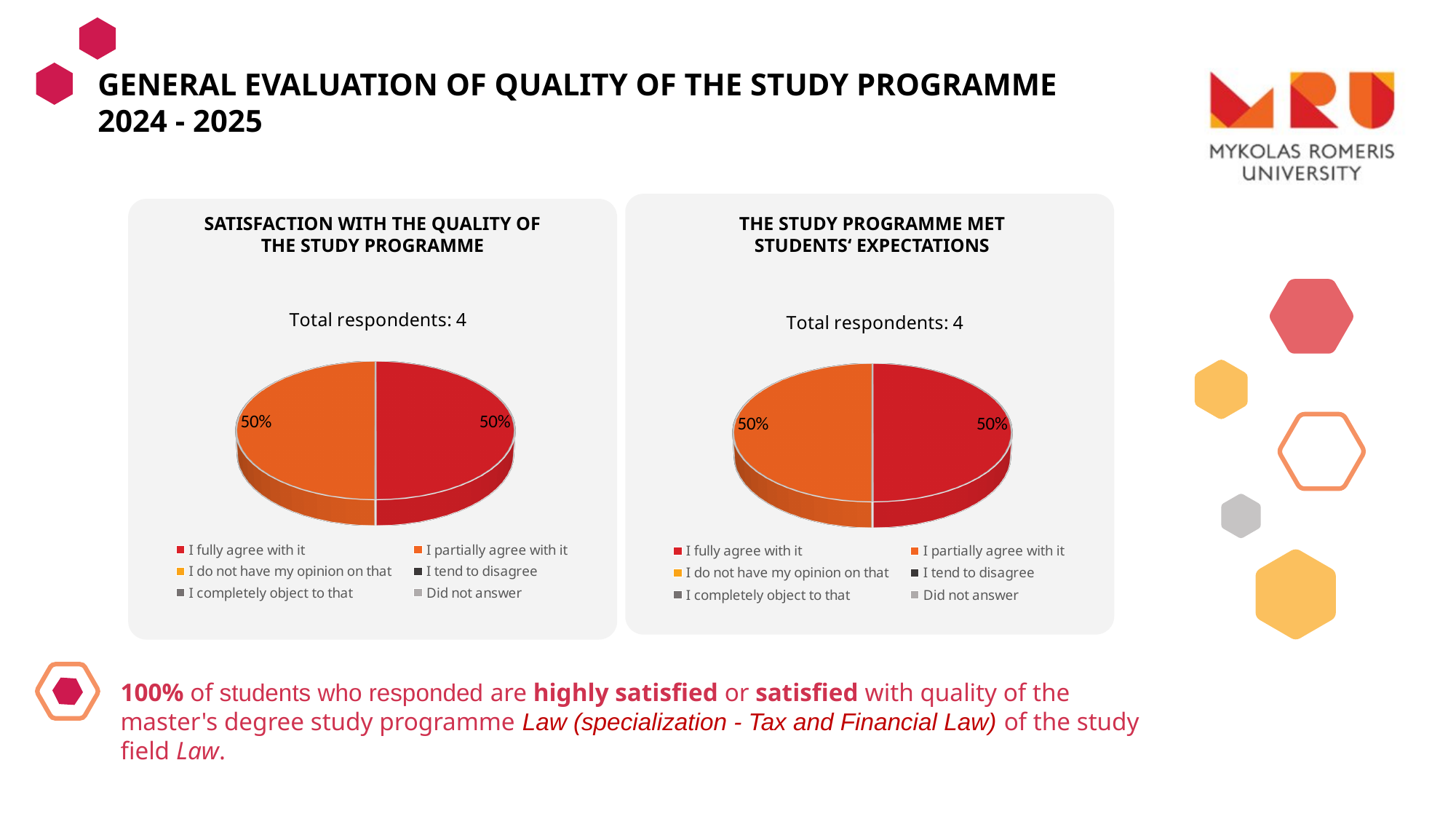
In the 'The study programme met students' expectations' chart, which colour represents 'I partially agree with it'? Orange In the 'The study programme met students' expectations' chart, what share of respondents chose 'I fully agree with it'? 50% How many entries does the legend of the 'Satisfaction with the quality of the study programme' chart list? 6 How many entries does the legend of the 'The study programme met students' expectations' chart list? 6 What kind of chart is the 'Satisfaction with the quality of the study programme' chart? Pie chart How many total respondents are reported for the 'The study programme met students' expectations' chart? 4 What kind of chart is the 'The study programme met students' expectations' chart? Pie chart In the 'The study programme met students' expectations' chart, what share of respondents chose 'I partially agree with it'? 50% In the 'Satisfaction with the quality of the study programme' chart, what is the difference between the 'I fully agree with it' and 'I partially agree with it' shares? 0% In the 'Satisfaction with the quality of the study programme' chart, what share of respondents chose 'I partially agree with it'? 50% In the 'Satisfaction with the quality of the study programme' chart, what share of respondents chose 'I fully agree with it'? 50% How many slices are visible in the 'Satisfaction with the quality of the study programme' pie chart? 2